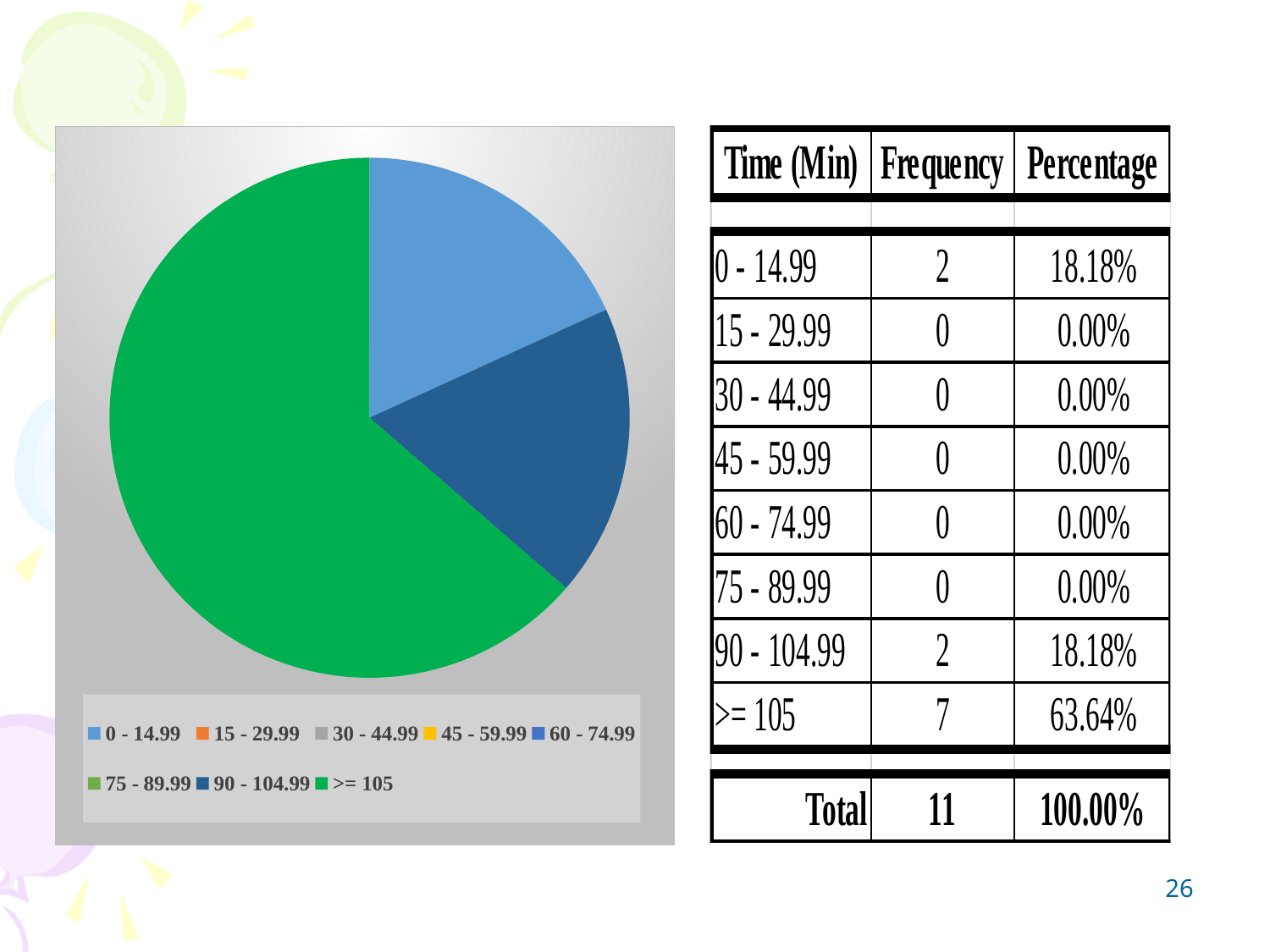
According to the table, what is the difference in frequency between the >= 105 category and the 0 - 14.99 category? 5 According to the table, what share of the total does the >= 105 category represent? 63.64% What kind of chart is shown on the left of the slide? pie chart Which category has the largest slice in the pie chart? >= 105 According to the table, what is the frequency for the 90 - 104.99 time range? 2 Which slice is larger in the pie chart: 0 - 14.99 or >= 105? >= 105 According to the table, what is the percentage for the 0 - 14.99 time range? 18.18% How many categories have a visible slice in the pie chart? 3 What is the total frequency shown in the table? 11 Which legend entry is shown in light blue in the pie chart? 0 - 14.99 How many categories does the pie chart's legend list? 8 What colour is the >= 105 slice in the pie chart? green